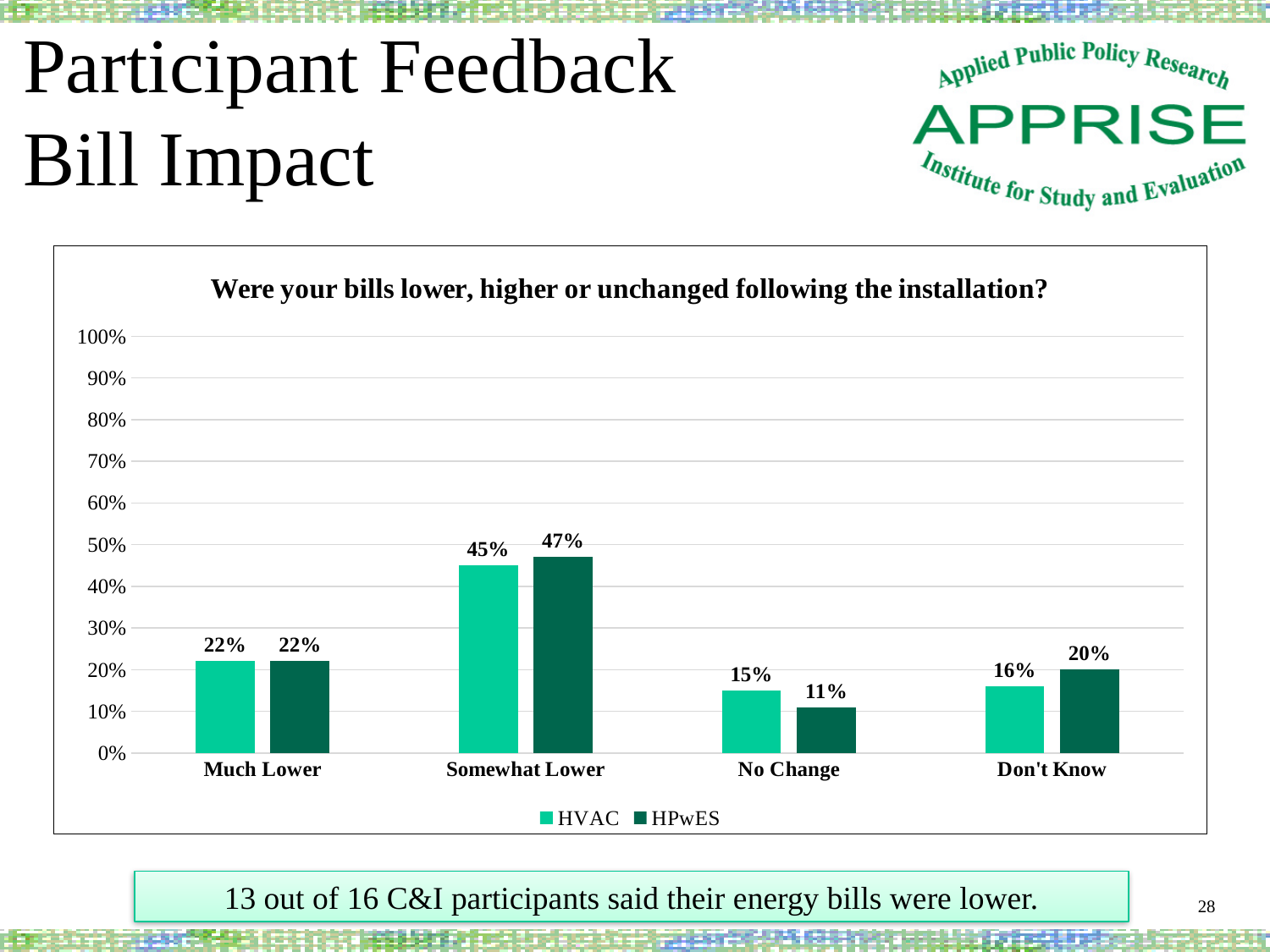
How many series does the legend list? 2 What is the HPwES value for No Change? 11% What is the difference between the HPwES and HVAC values for Somewhat Lower? 2% What is the title of the chart? Were your bills lower, higher or unchanged following the installation? How many categories are shown on the x axis? 4 What is the HPwES value for Don't Know? 20% Is the HVAC value for Much Lower greater or less than 30%? less Which is larger for No Change, the HVAC value or the HPwES value? HVAC Which category has the highest HPwES value? Somewhat Lower What is the HVAC value for Somewhat Lower? 45% Which category has the lowest HVAC value? No Change What kind of chart is shown? bar chart